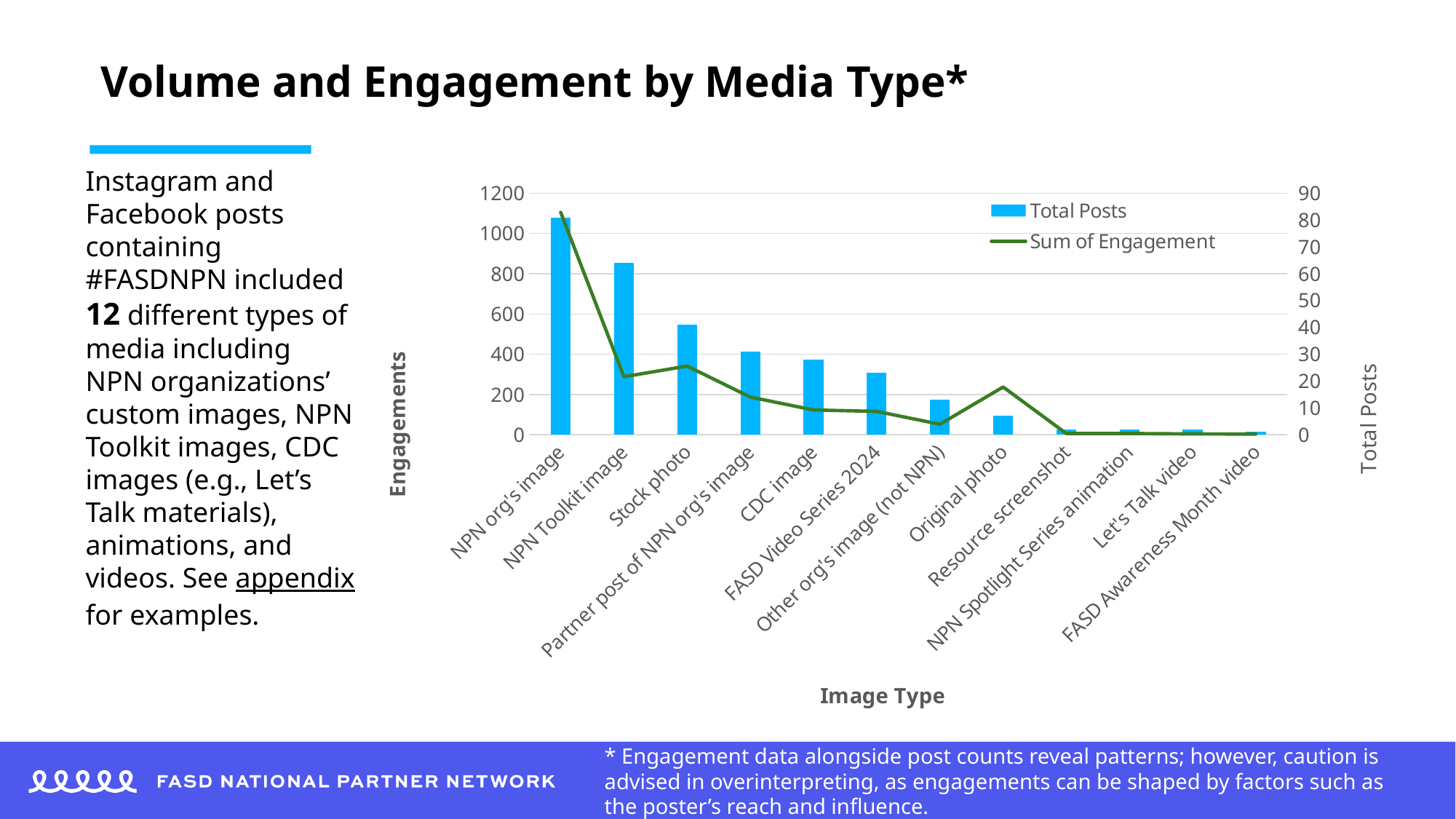
How many series does the chart legend list? 2 How many image types (categories) are shown on the x axis of the chart? 12 Which image type has the highest Sum of Engagement? NPN org's image Is the Total Posts value for Stock photo greater or less than 30? greater What is the title of the x axis of the chart? Image Type Which has a higher Sum of Engagement, Stock photo or CDC image? Stock photo Is the Total Posts value for Original photo greater or less than 20? less Is the Sum of Engagement for NPN Toolkit image greater or less than 400? less Do the Total Posts bars generally rise or fall moving from left to right along the x axis? fall Which has more Total Posts, NPN Toolkit image or Stock photo? NPN Toolkit image Which image type has the highest Total Posts bar? NPN org's image What type of chart is shown on the slide? A combined bar and line chart